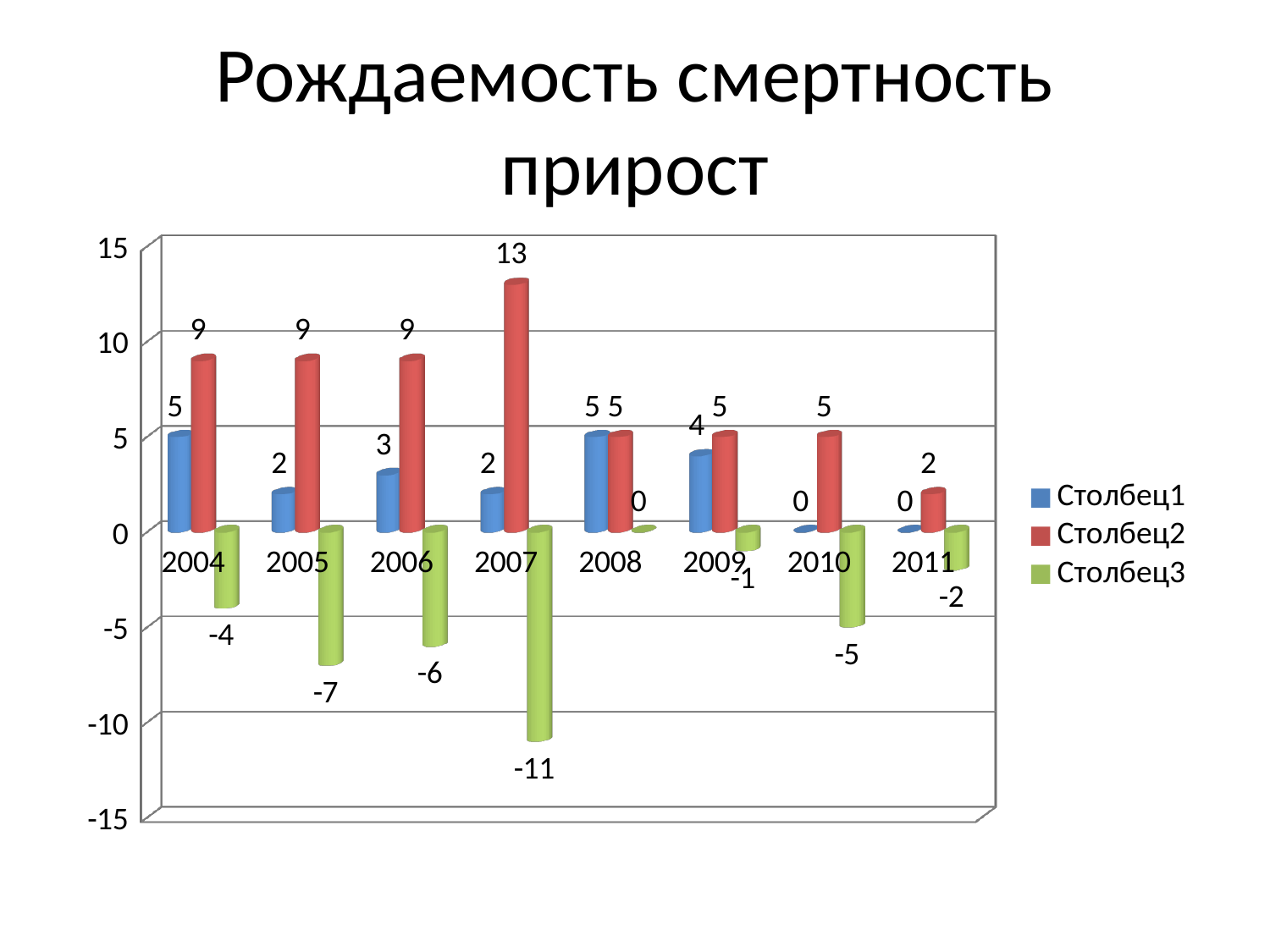
How many years are shown on the x axis? 8 Does Столбец2 rise or fall from 2007 to 2011? fall What is the difference between Столбец2 and Столбец1 in 2004? 4 In which year is Столбец2 highest? 2007 What is the value of Столбец2 for 2007? 13 What colour represents Столбец3 in the chart? green How many series does the legend list? 3 What is the value of Столбец3 for 2005? -7 What is the value of Столбец1 for 2009? 4 What type of chart is shown on the slide? bar chart In which year is Столбец3 lowest? 2007 Which is larger in 2006, Столбец1 or Столбец2? Столбец2